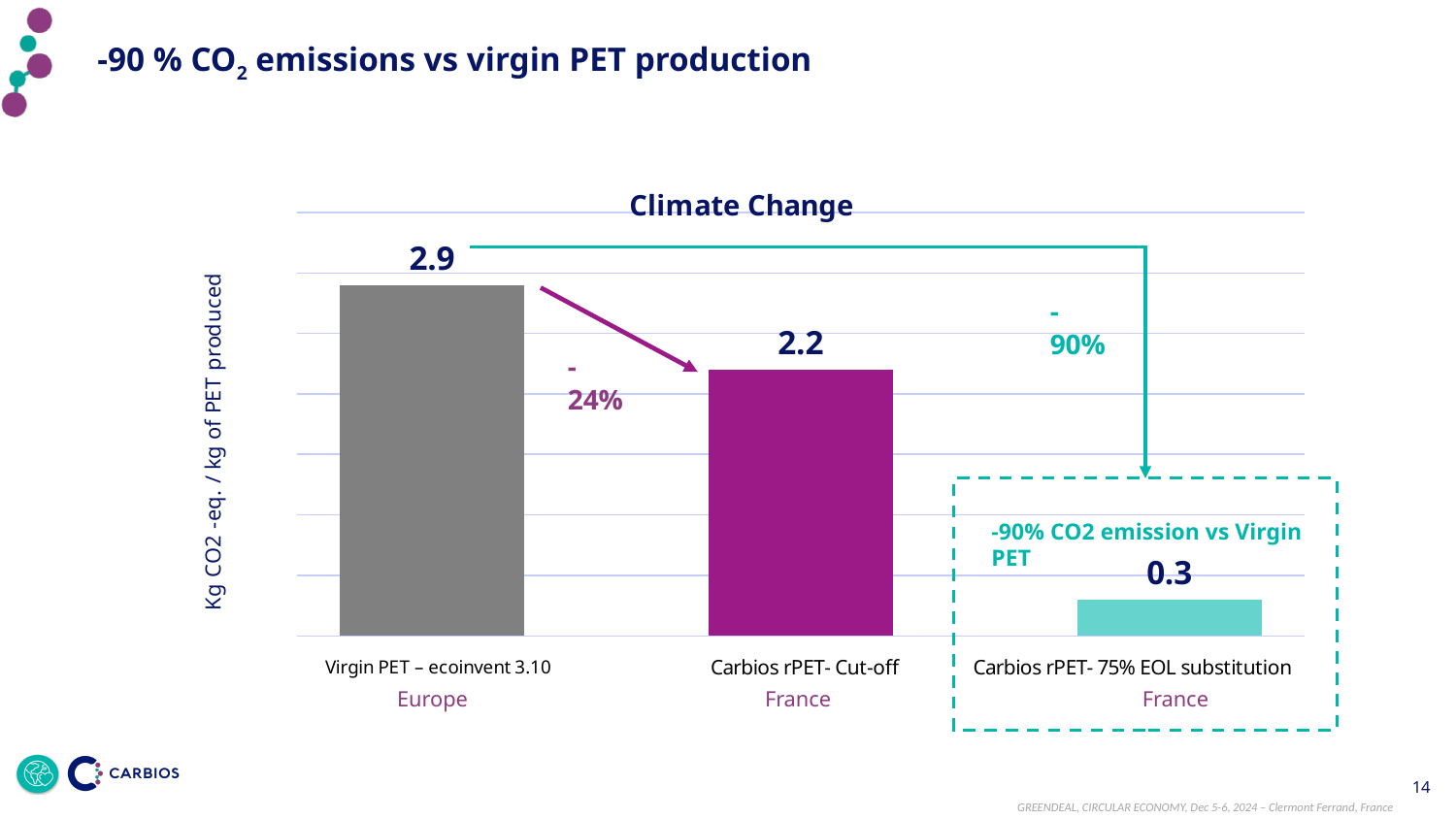
How many bars are shown in the Climate Change chart? 3 Which category has the lowest value in the Climate Change chart? Carbios rPET- 75% EOL substitution Which category has the highest value in the Climate Change chart? Virgin PET – ecoinvent 3.10 What is the y-axis label of the Climate Change chart? Kg CO2 -eq. / kg of PET produced What is the difference between the values for Virgin PET – ecoinvent 3.10 and Carbios rPET- 75% EOL substitution? 2.6 What kind of chart is shown on the slide? Bar chart Which is larger, the value for Carbios rPET- Cut-off or the value for Carbios rPET- 75% EOL substitution? Carbios rPET- Cut-off What is the value for Virgin PET – ecoinvent 3.10 in the Climate Change chart? 2.9 What is the value for Carbios rPET- Cut-off in the Climate Change chart? 2.2 What is the difference between the values for Virgin PET – ecoinvent 3.10 and Carbios rPET- Cut-off? 0.7 What is the value for Carbios rPET- 75% EOL substitution in the Climate Change chart? 0.3 Do the values rise or fall from left to right across the Climate Change chart? Fall